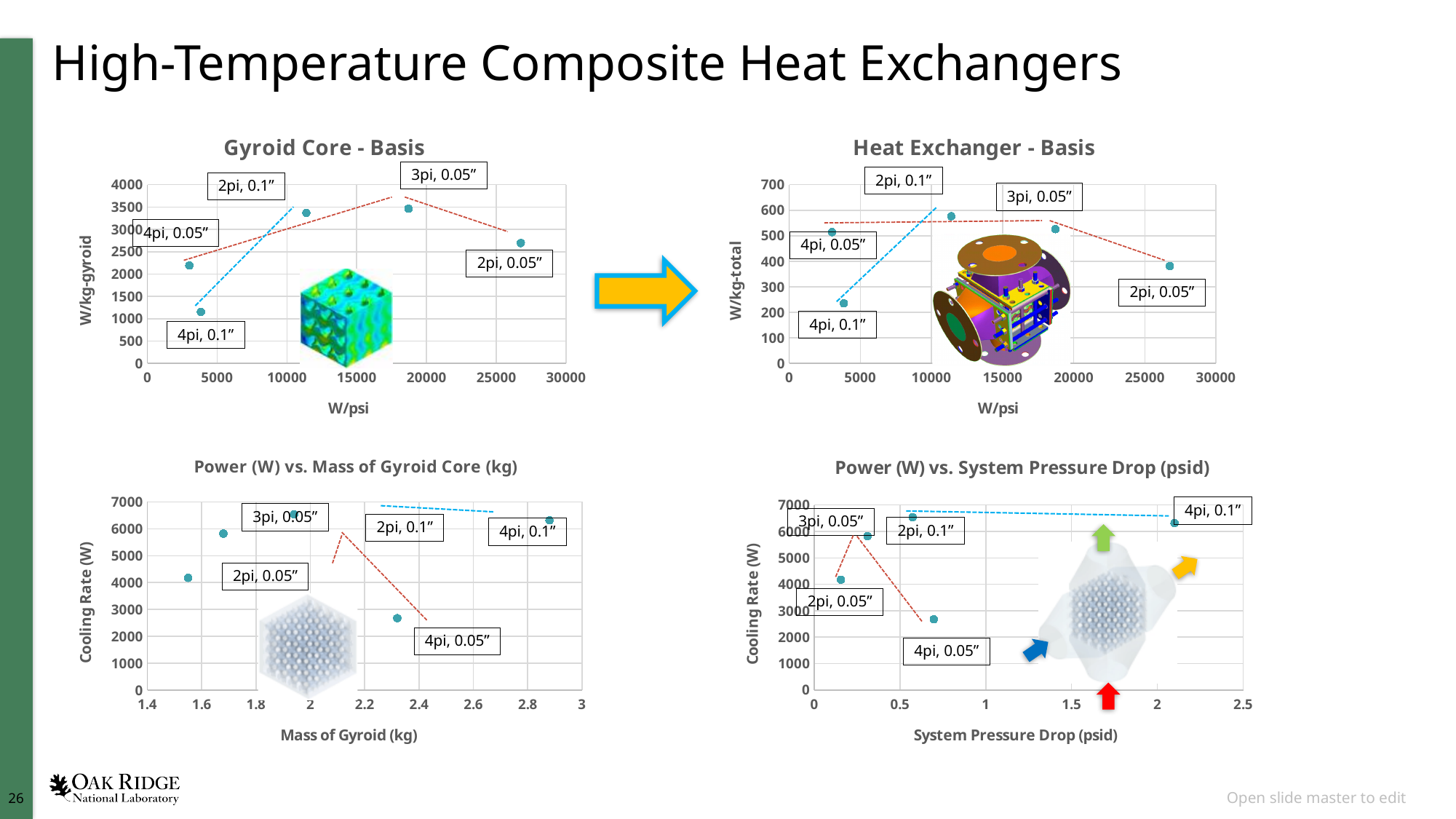
How many data points are plotted in the "Gyroid Core - Basis" chart? 5 In the "Gyroid Core - Basis" chart, which labelled point has the lowest W/kg-gyroid value? 4pi, 0.1″ In the "Heat Exchanger - Basis" chart, which has the higher W/kg-total value: the point labelled "2pi, 0.1″" or the point labelled "2pi, 0.05″"? 2pi, 0.1″ In the "Gyroid Core - Basis" chart, which labelled point has the highest W/psi value? 2pi, 0.05″ In the "Power (W) vs. Mass of Gyroid Core (kg)" chart, which labelled point has the lowest Cooling Rate (W)? 4pi, 0.05″ In the "Power (W) vs. System Pressure Drop (psid)" chart, is the Cooling Rate (W) for the point labelled "4pi, 0.05″" greater or less than 3000? less What kind of chart is the "Gyroid Core - Basis" chart? Scatter chart In the "Heat Exchanger - Basis" chart, is the W/kg-total value for the point labelled "2pi, 0.05″" greater or less than 400? less In the "Gyroid Core - Basis" chart, is the W/kg-gyroid value for the point labelled "4pi, 0.05″" greater or less than 2500? less In the "Power (W) vs. System Pressure Drop (psid)" chart, which labelled point has the highest System Pressure Drop (psid)? 4pi, 0.1″ What is the x-axis title of the "Power (W) vs. Mass of Gyroid Core (kg)" chart? Mass of Gyroid (kg) In the "Heat Exchanger - Basis" chart, which labelled point has the lowest W/kg-total value? 4pi, 0.1″